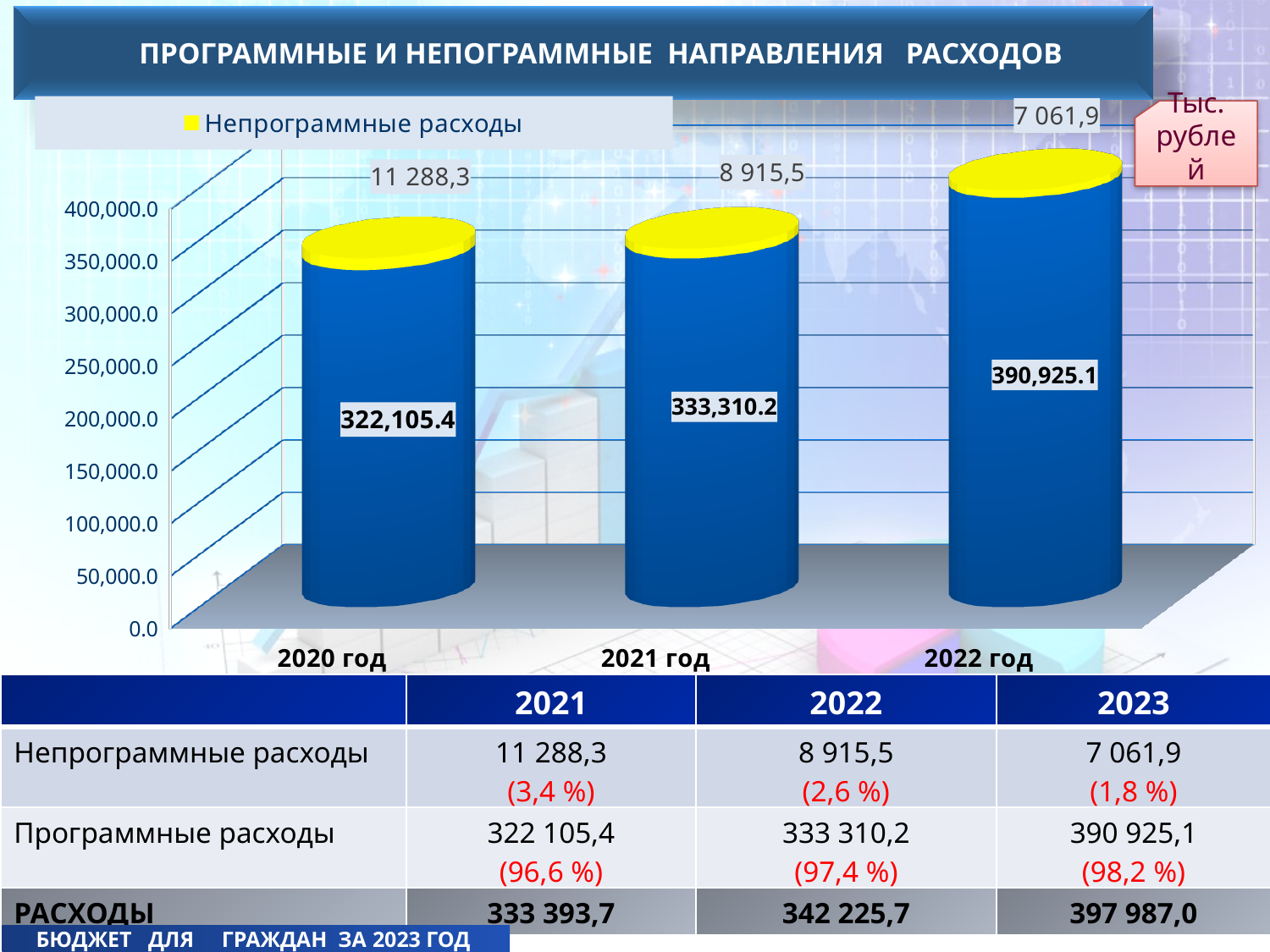
What is the value of the blue (programme expenditure) segment for 2022 год? 390,925.1 What is the value of the yellow (Непрограммные расходы) segment for 2020 год? 11 288,3 What type of chart is shown on the slide? bar chart Is the blue (programme expenditure) value for 2020 год greater or less than 300,000.0? greater Do the blue (programme expenditure) values rise or fall from 2020 год to 2022 год? rise What is the value of the blue (programme expenditure) segment for 2021 год? 333,310.2 How many year categories are shown on the chart's x axis? 3 What is the value of the blue (programme expenditure) segment for 2020 год? 322,105.4 Which year has the highest blue (programme expenditure) value? 2022 год Which year has the lowest yellow (Непрограммные расходы) value? 2022 год What is the value of the yellow (Непрограммные расходы) segment for 2022 год? 7 061,9 Which series name is listed in the chart legend? Непрограммные расходы